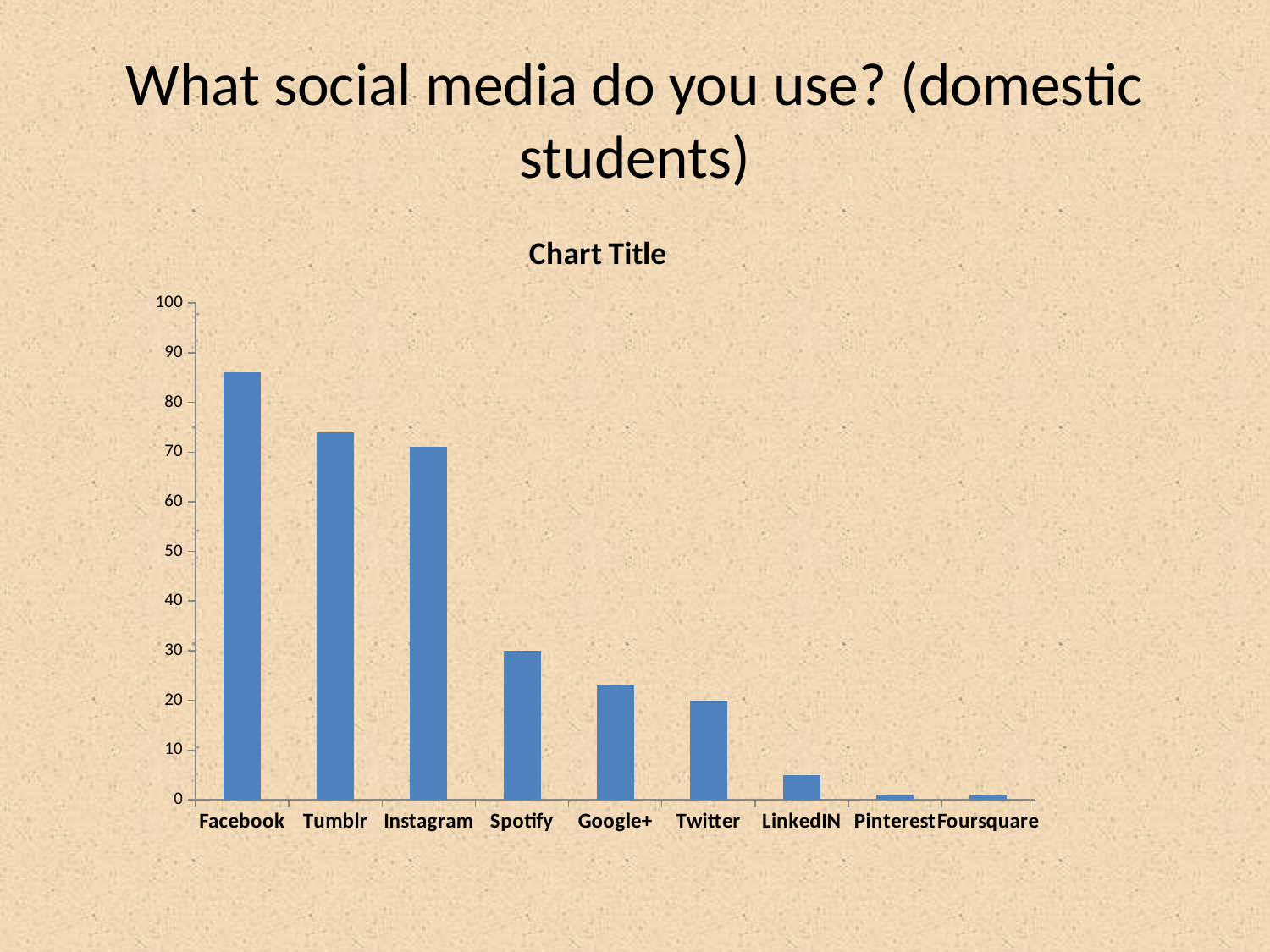
Do the values generally rise or fall moving from left to right along the x axis? fall Is the value for Google+ greater or less than 30? less Is the value for LinkedIN greater or less than 10? less How many social media categories are shown on the x axis? 9 Which has a larger value, Tumblr or Spotify? Tumblr Is the value for Tumblr greater or less than 70? greater What kind of chart is shown on the slide? bar chart What is the title printed above the chart? Chart Title Which social media category has the highest value? Facebook